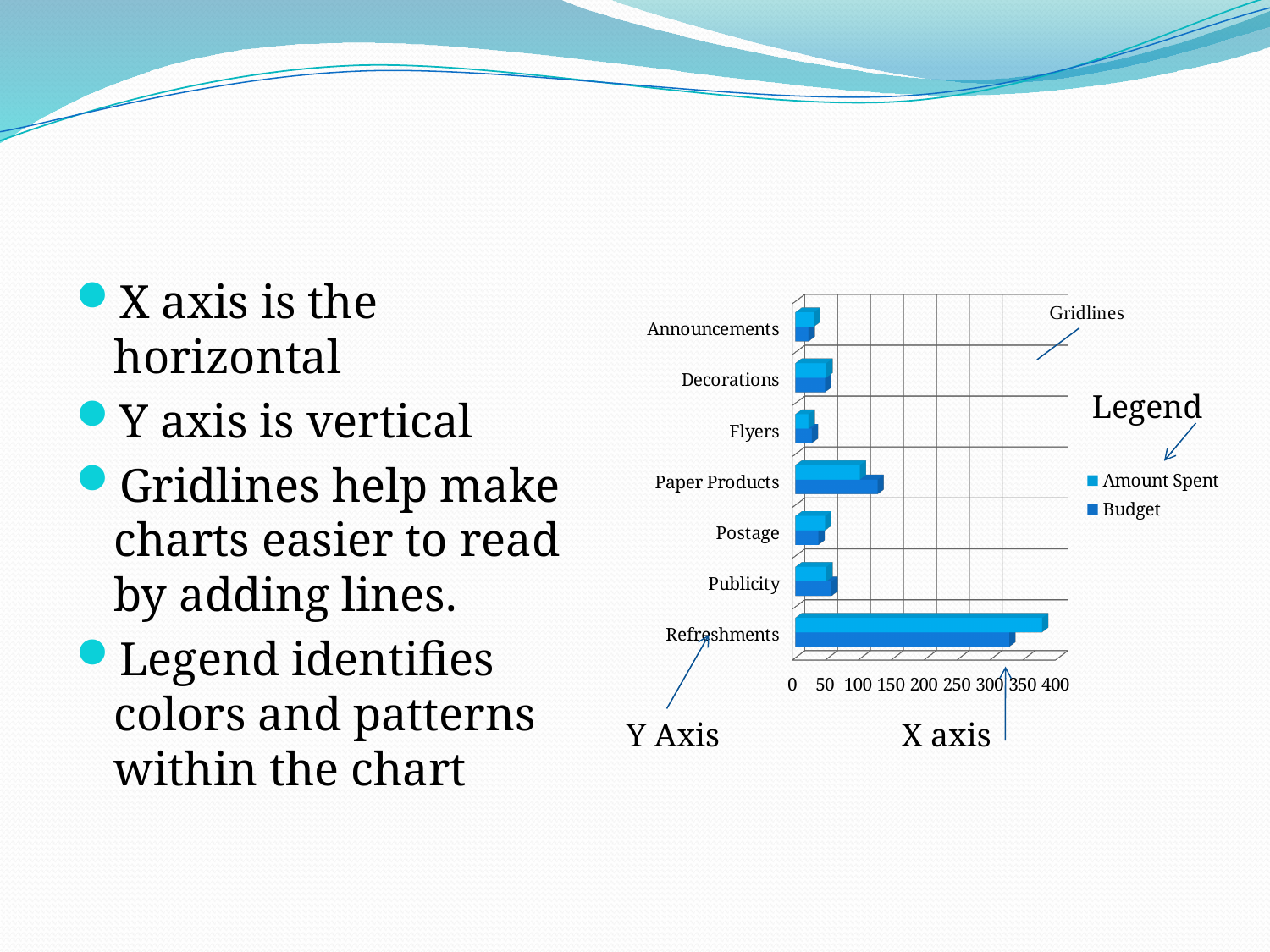
How many series does the chart's legend list? 2 Which is larger, the Budget for Paper Products or the Budget for Flyers? Paper Products How many categories are listed on the vertical axis of the chart? 7 What is the highest tick value shown on the chart's horizontal axis? 400 Is the Amount Spent value for Refreshments greater or less than 300? greater Which category has the highest Amount Spent value? Refreshments Which is larger, the Amount Spent for Refreshments or the Amount Spent for Paper Products? Refreshments Which category has the highest Budget value? Refreshments What are the two series named in the chart's legend? Amount Spent and Budget What kind of chart is shown on the slide? bar chart Is the Amount Spent value for Paper Products greater or less than 150? less Is the Budget value for Flyers greater or less than 100? less